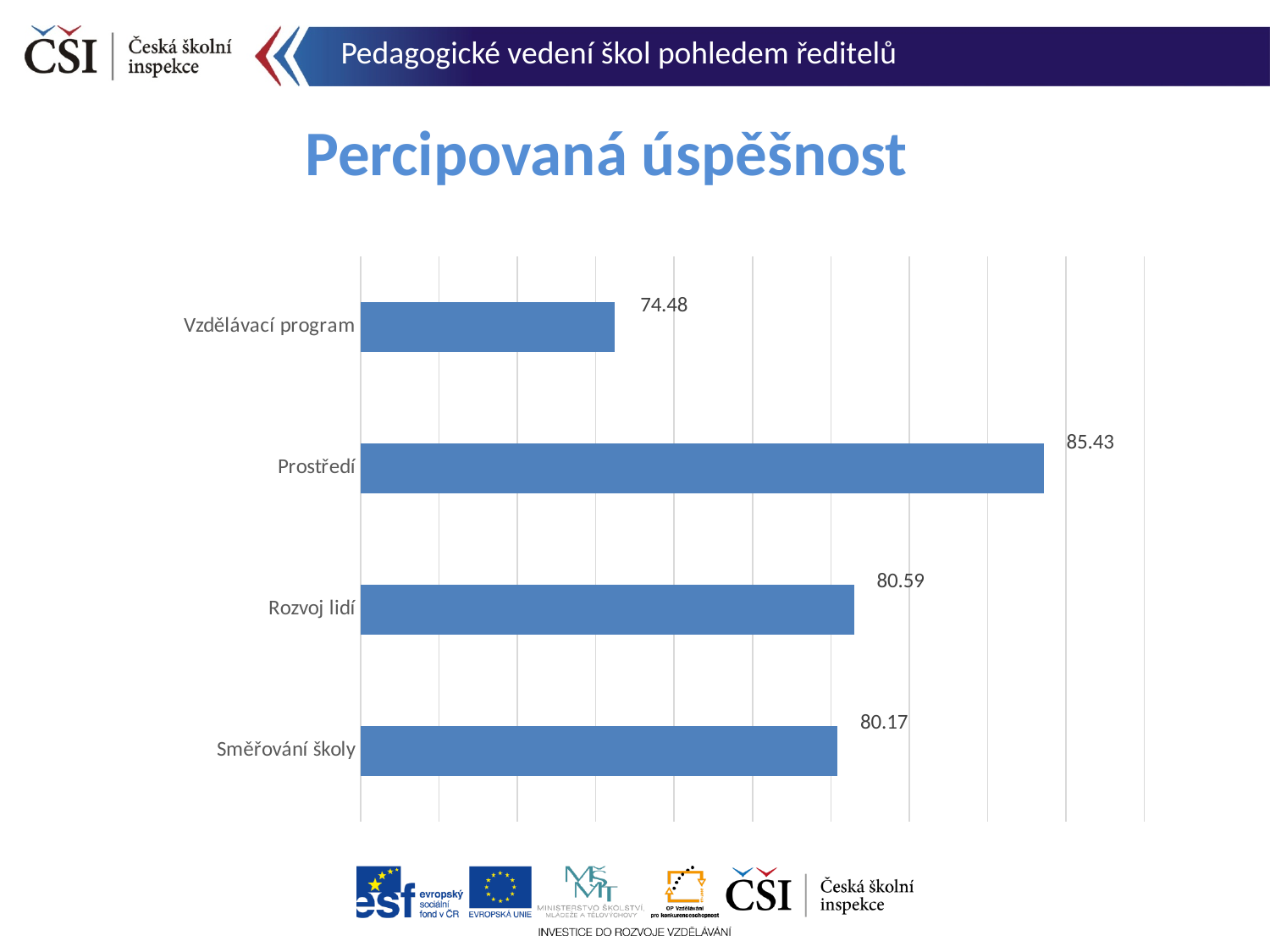
What is the value for Vzdělávací program? 74.48 Which category has the highest value? Prostředí What is the value for Směřování školy? 80.17 What is the value for Prostředí? 85.43 Which category has the lowest value? Vzdělávací program What kind of chart is shown on the slide? Bar chart Which is larger, the value for Prostředí or the value for Rozvoj lidí? Prostředí What is the title of the chart? Percipovaná úspěšnost What is the difference between the values for Prostředí and Vzdělávací program? 10.95 What is the value for Rozvoj lidí? 80.59 How many categories are shown in the chart? 4 What is the difference between the values for Rozvoj lidí and Směřování školy? 0.42